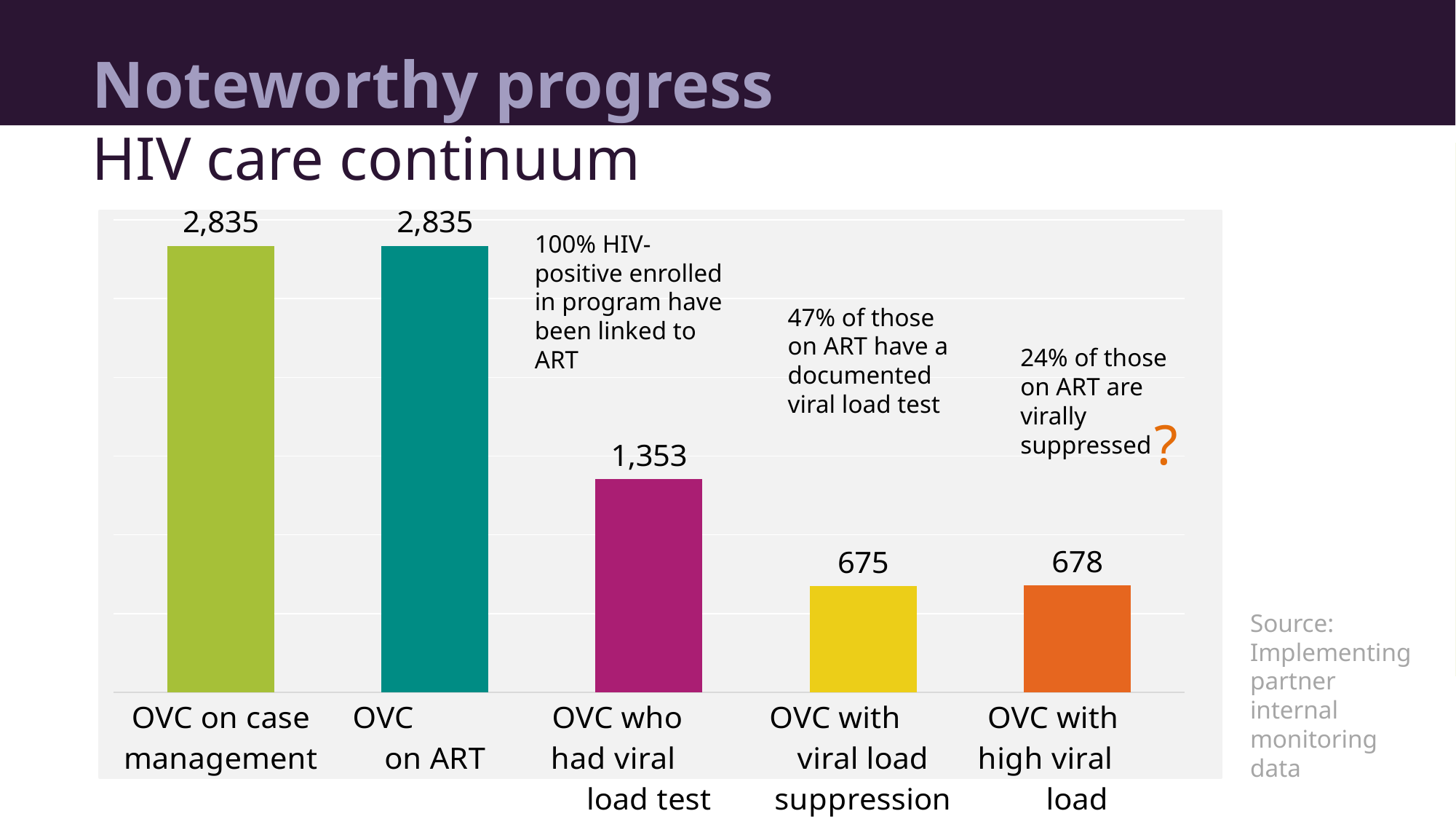
Which is larger, the value for OVC on ART or the value for OVC who had viral load test? OVC on ART What is the difference between the value for OVC on ART and the value for OVC who had viral load test? 1,482 What is the value for OVC with viral load suppression? 675 What is the value for OVC who had viral load test? 1,353 What is the value for OVC with high viral load? 678 What kind of chart is shown on the slide? Bar chart What is the difference between the value for OVC who had viral load test and the value for OVC with viral load suppression? 678 What is the value for OVC on case management? 2,835 According to the annotation on the chart, what percentage of those on ART have a documented viral load test? 47% What is the source given for the chart data? Implementing partner internal monitoring data What is the value for OVC on ART? 2,835 How many categories are shown in the chart? 5